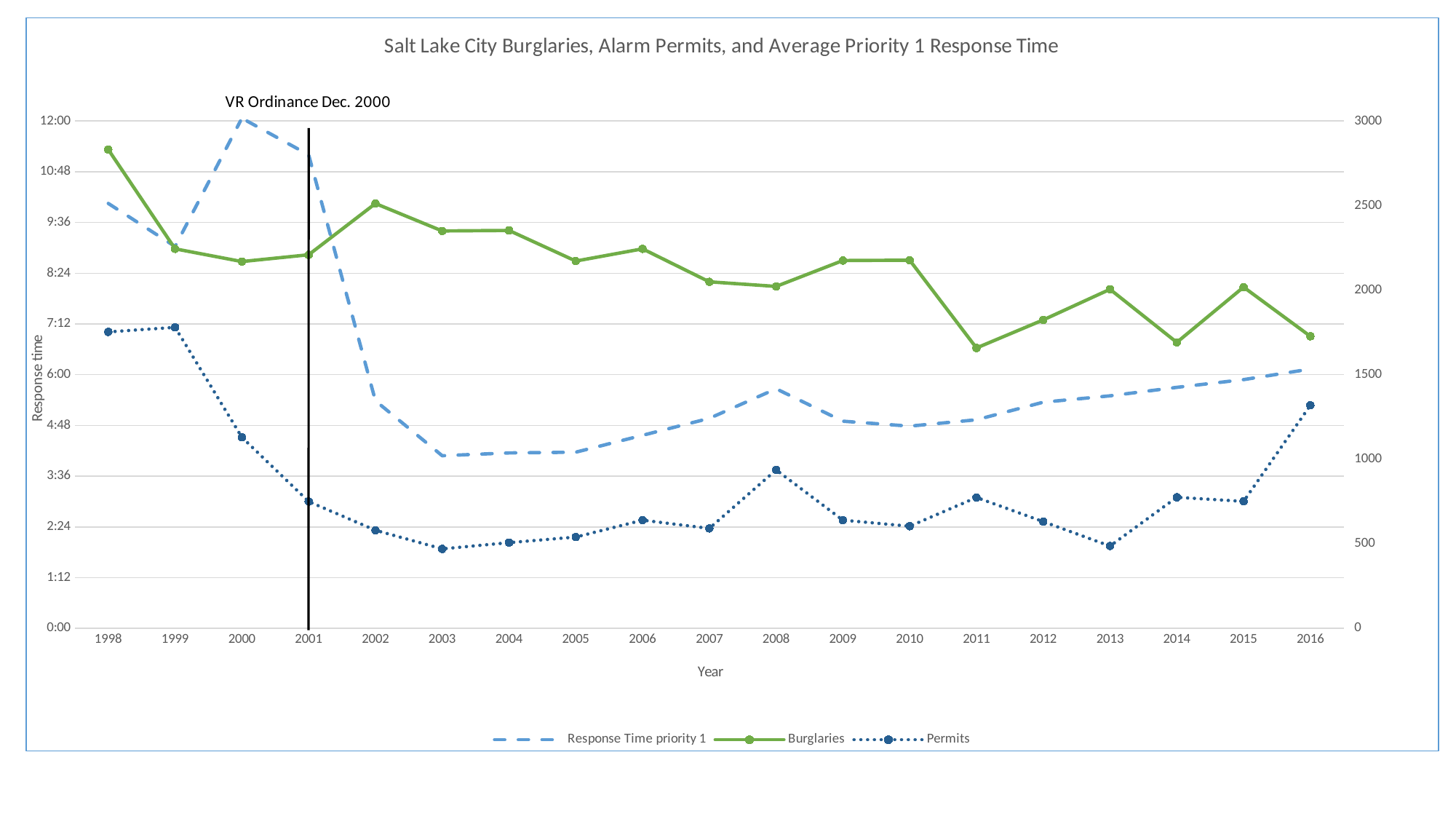
How many series does the legend list? 3 Is the Burglaries value for 2011 greater or less than 2000? less Is the Response Time priority 1 value for 2003 greater or less than 4:48? less Is the Permits value for 2016 greater or less than 1000? greater How many years are plotted along the x axis? 19 What kind of chart is shown on the slide? Line chart In which year is the Response Time priority 1 value highest? 2000 In which year is the Burglaries value highest? 1998 Do Burglaries generally rise or fall from 1998 to 2016? Fall Which year has the larger Permits value, 1998 or 2003? 1998 What event does the vertical line annotation on the chart mark? VR Ordinance Dec. 2000